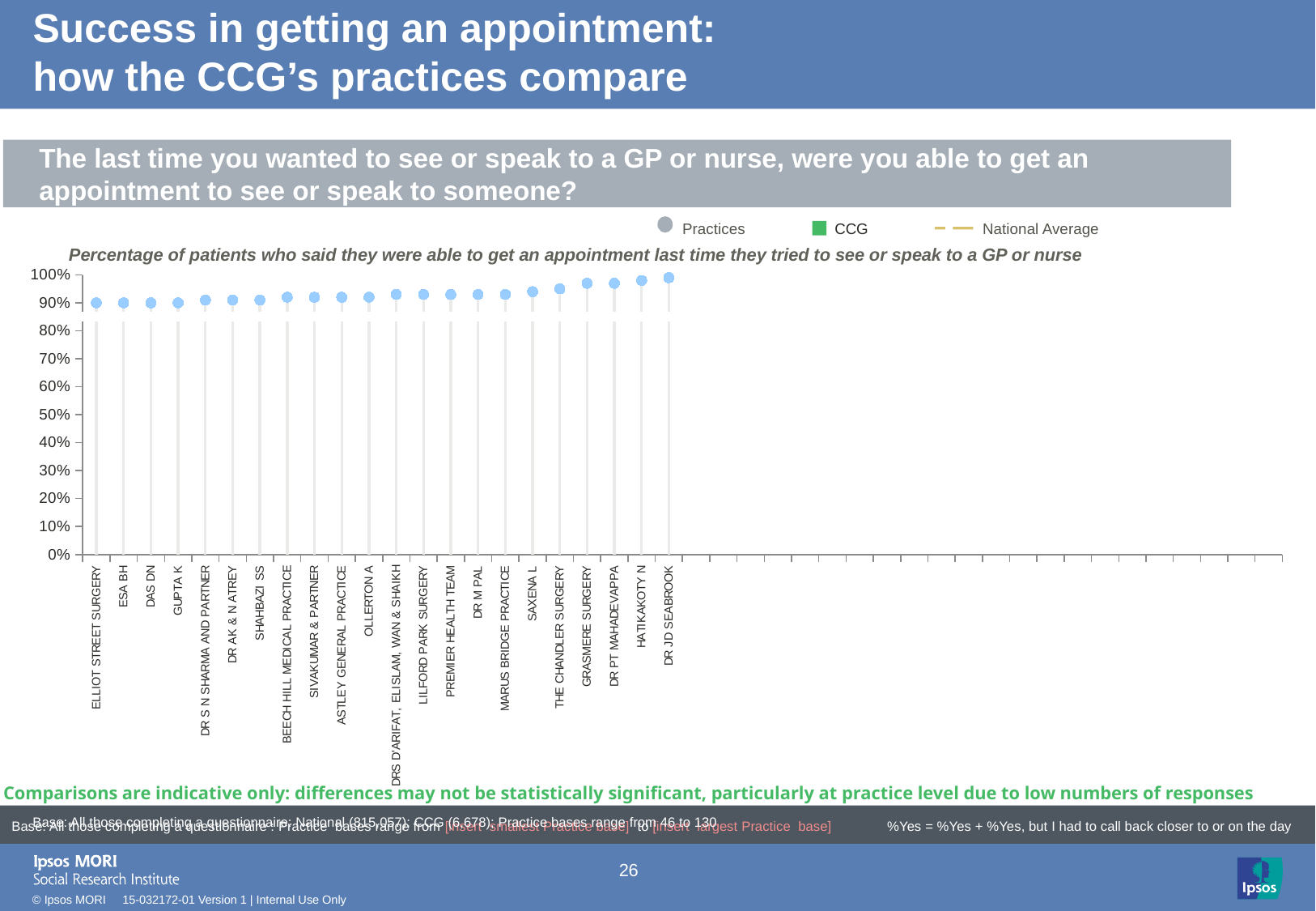
Is the value for ELLIOT STREET SURGERY greater or less than 80%? greater Is the value for DR JD SEABROOK greater or less than 90%? greater How many entries does the chart legend list? 3 Which has the higher value, GRASMERE SURGERY or DAS DN? GRASMERE SURGERY Which has the higher value, DR JD SEABROOK or ELLIOT STREET SURGERY? DR JD SEABROOK Is the value for GRASMERE SURGERY greater or less than 50%? greater Do the plotted values rise or fall moving from left to right along the x axis? rise What are the three entries in the chart legend? Practices, CCG, National Average Which practice is plotted first (leftmost) on the x axis? ELLIOT STREET SURGERY What is the highest value shown on the y axis? 100% How many practices are plotted on the chart? 22